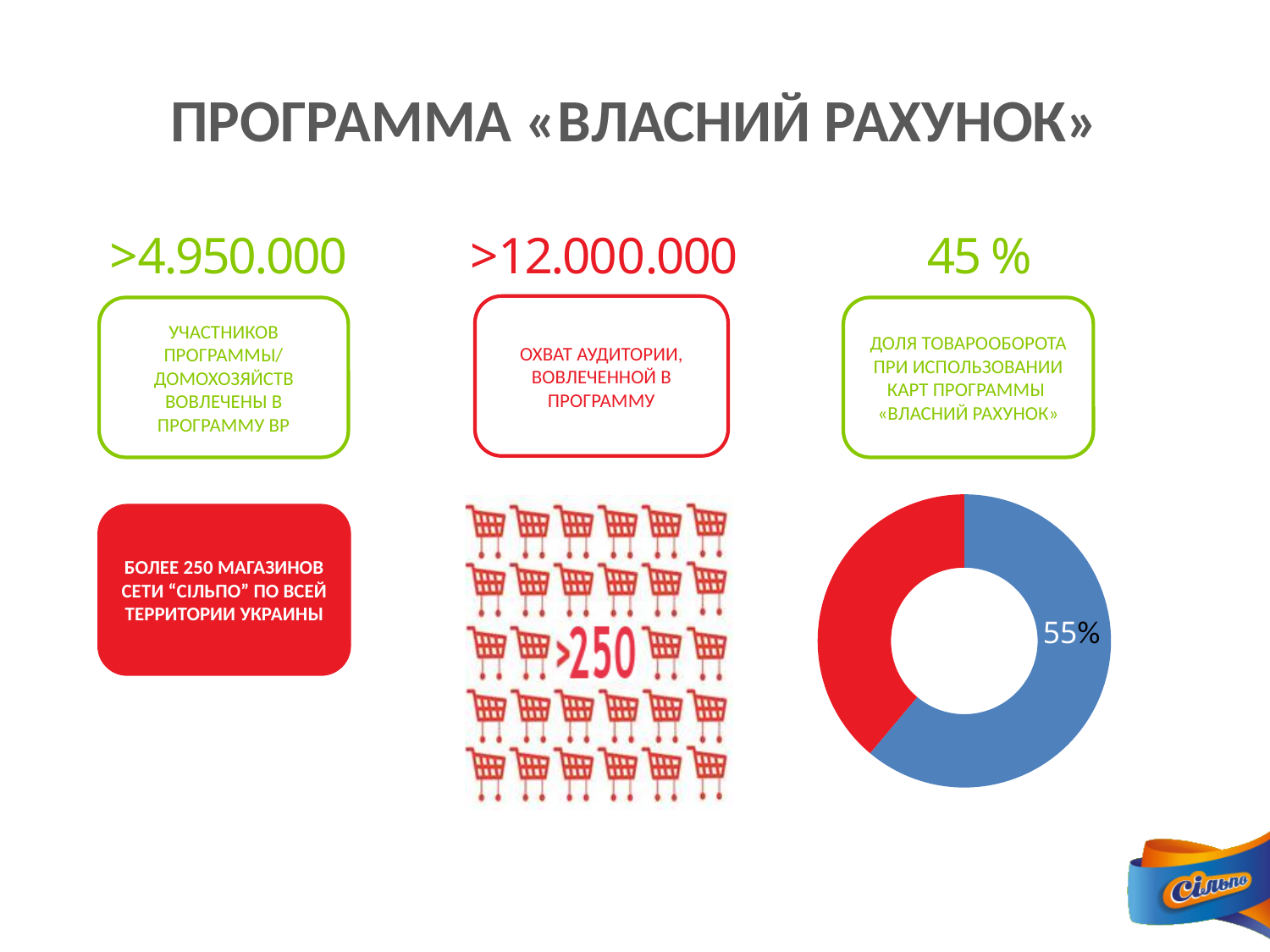
What value is labelled on the blue slice of the doughnut chart? 55% Does the doughnut chart on the slide show a legend? No What colour is the slice of the doughnut chart labelled 55%? Blue Is the blue slice of the doughnut chart greater or less than 50% of the whole? greater Which slice of the doughnut chart is larger, the blue one or the red one? Blue What kind of chart is shown at the bottom right of the slide? Doughnut (pie) chart Which slice of the doughnut chart is the smallest? The red slice How many slices does the doughnut chart at the bottom right have? 2 Is the red slice of the doughnut chart greater or less than 50% of the whole? less